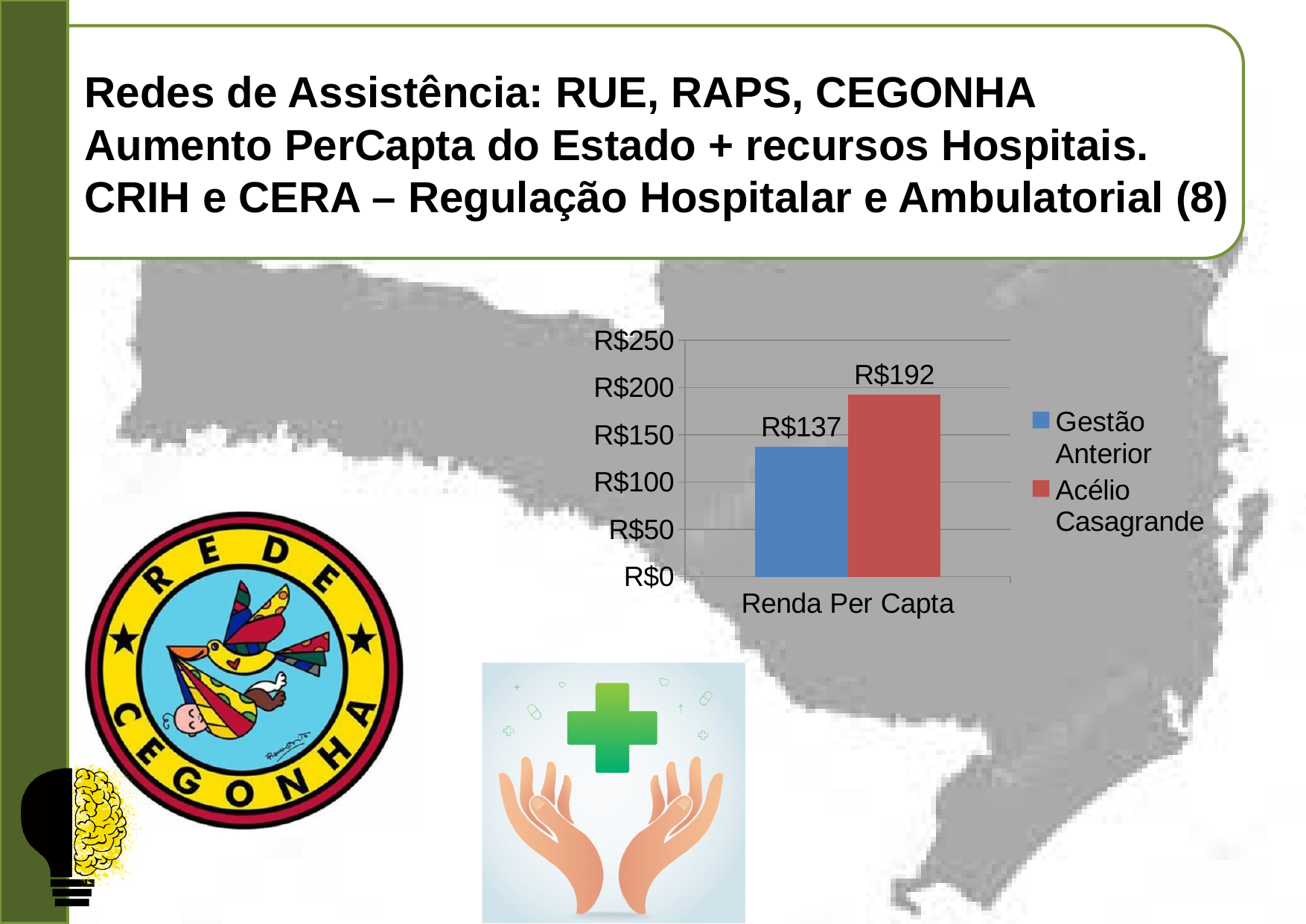
Which series has the lower value for Renda Per Capta? Gestão Anterior Is the value for Gestão Anterior greater or less than R$150? less What is the difference between the Acélio Casagrande and Gestão Anterior values for Renda Per Capta? R$55 What is the value for Gestão Anterior in the Renda Per Capta chart? R$137 What is the category label on the x axis of the chart? Renda Per Capta How many series does the legend list? 2 How many categories are shown on the x axis of the chart? 1 What is the value for Acélio Casagrande in the Renda Per Capta chart? R$192 Is the value for Gestão Anterior larger or smaller than the value for Acélio Casagrande? smaller Is the value for Acélio Casagrande greater or less than R$150? greater What kind of chart is shown on the slide? bar chart Which series has the higher value for Renda Per Capta? Acélio Casagrande